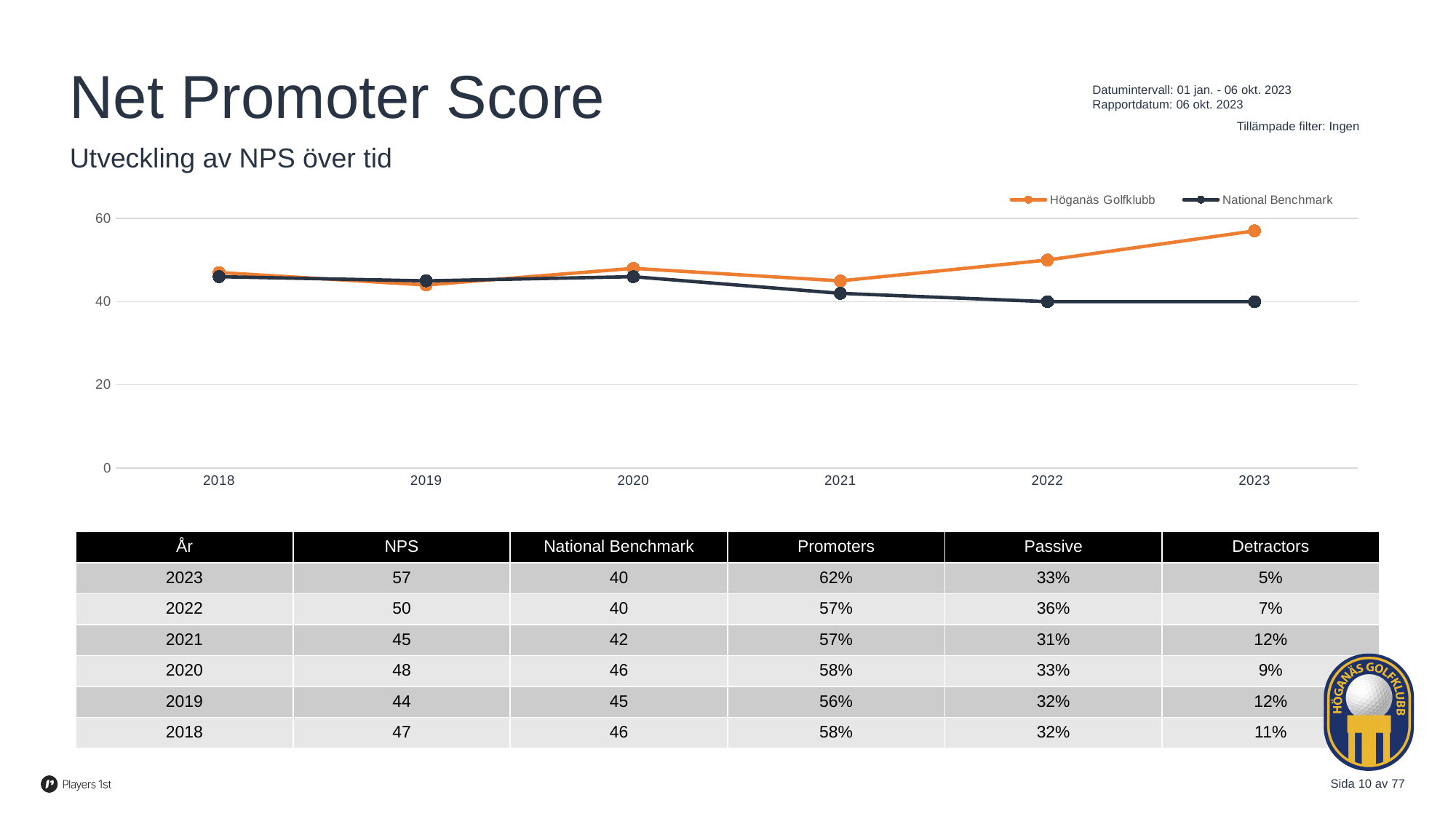
Does the Höganäs Golfklubb line rise or fall from 2021 to 2023? rise In which year is the Höganäs Golfklubb NPS lowest? 2019 How many years are plotted along the x axis of the chart? 6 Is the National Benchmark value for 2022 greater or less than 60? less Which series is drawn in orange in the chart? Höganäs Golfklubb In which year is the Höganäs Golfklubb NPS highest? 2023 In 2019, which is larger: Höganäs Golfklubb or the National Benchmark? National Benchmark How many series does the chart legend list? 2 What is the National Benchmark value in 2021? 42 What is the difference between Höganäs Golfklubb and the National Benchmark in 2023? 17 What is the NPS value for Höganäs Golfklubb in 2023? 57 What type of chart is shown on the slide? line chart